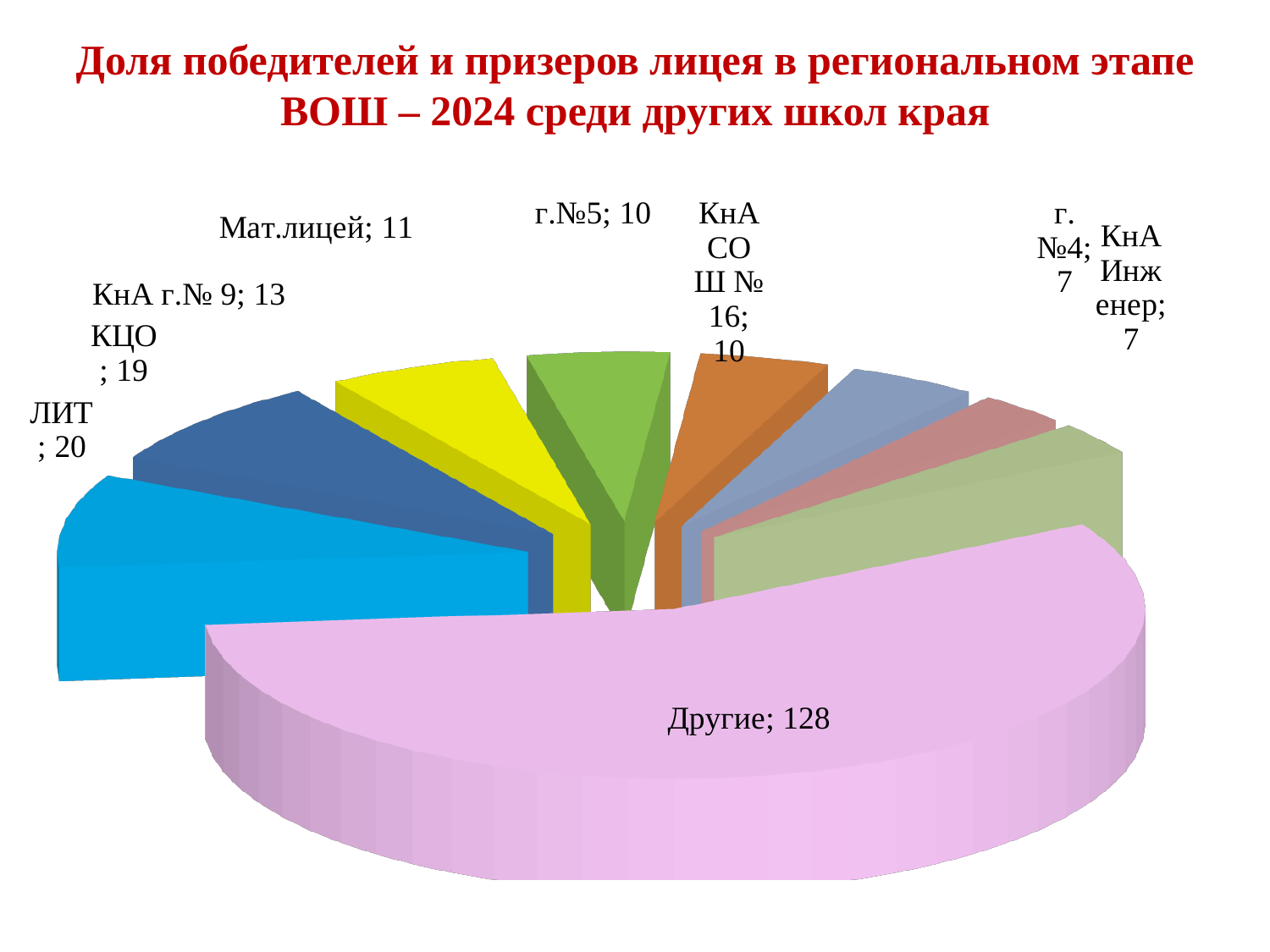
What value is shown for the ЛИТ slice? 20 What is the total of all the slice values in the pie chart? 225 How many slices does the pie chart have? 9 What kind of chart is shown on the slide? Pie chart Which two slices share the smallest value of 7? г.№4 and КнА Инженер What value is shown for the Другие slice? 128 What value is shown for the КЦО slice? 19 What value is shown for Мат.лицей? 11 Which has the larger value, ЛИТ or КЦО? ЛИТ What is the difference between the values for Другие and ЛИТ? 108 What value is shown for КнА г.№ 9? 13 Which slice has the largest value? Другие